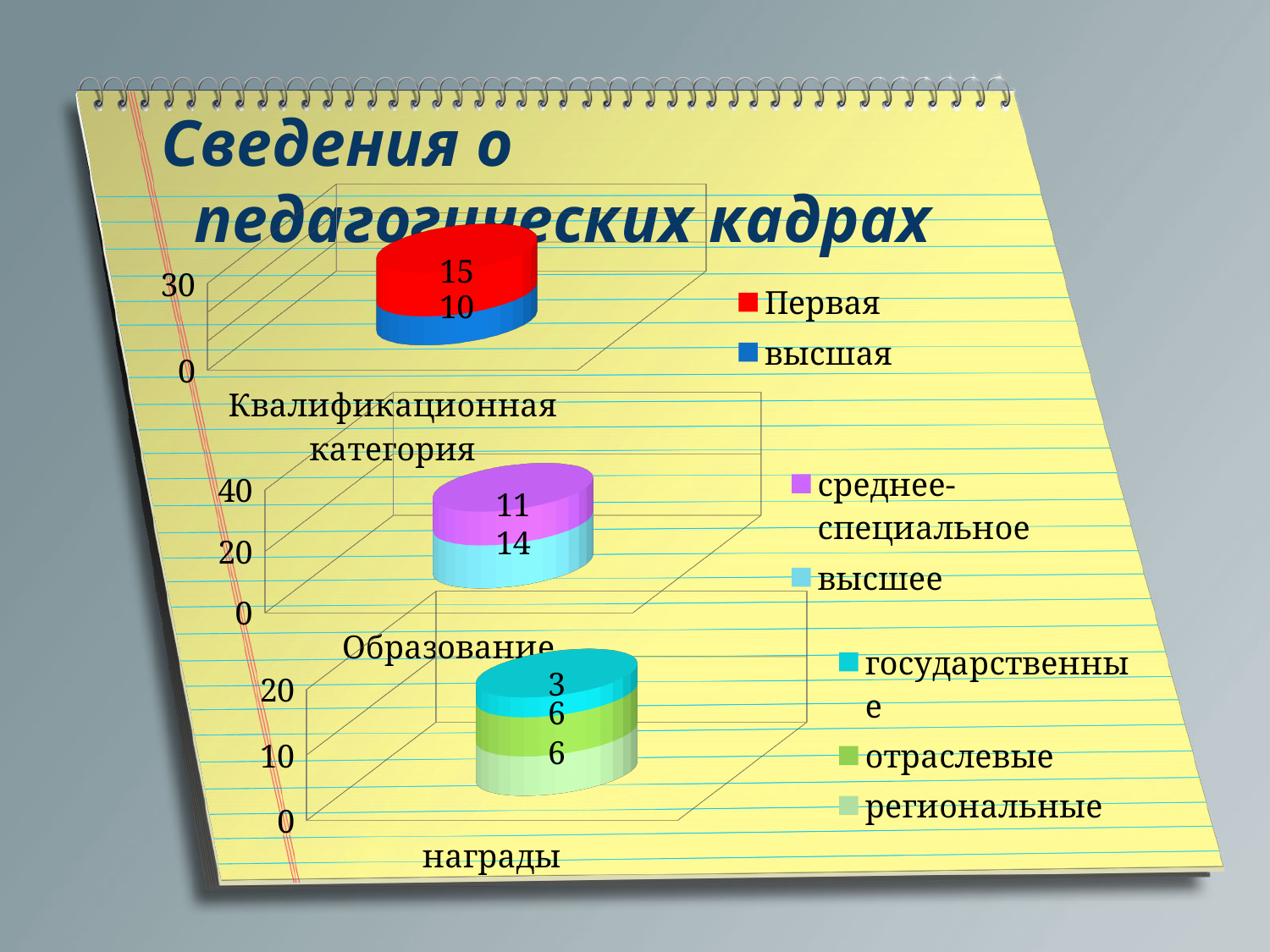
In the chart labelled "награды", how many series does the legend list? 3 In the chart labelled "Образование", what is the total of the stacked bar? 25 In the chart labelled "Образование", which is larger, "среднее-специальное" or "высшее"? высшее In the chart labelled "награды", what is the total of the stacked bar? 15 In the chart labelled "награды", what is the value for "государственные"? 3 In the chart labelled "Квалификационная категория", what is the value for "Первая"? 15 In the chart labelled "Квалификационная категория", what is the difference between "Первая" and "высшая"? 5 In the chart labelled "Квалификационная категория", what is the total of the stacked bar? 25 In the chart labelled "Образование", what is the value for "среднее-специальное"? 11 What kind of chart is the chart labelled "награды"? Stacked bar chart In the chart labelled "Квалификационная категория", what is the value for "высшая"? 10 In the chart labelled "Образование", what is the value for "высшее"? 14